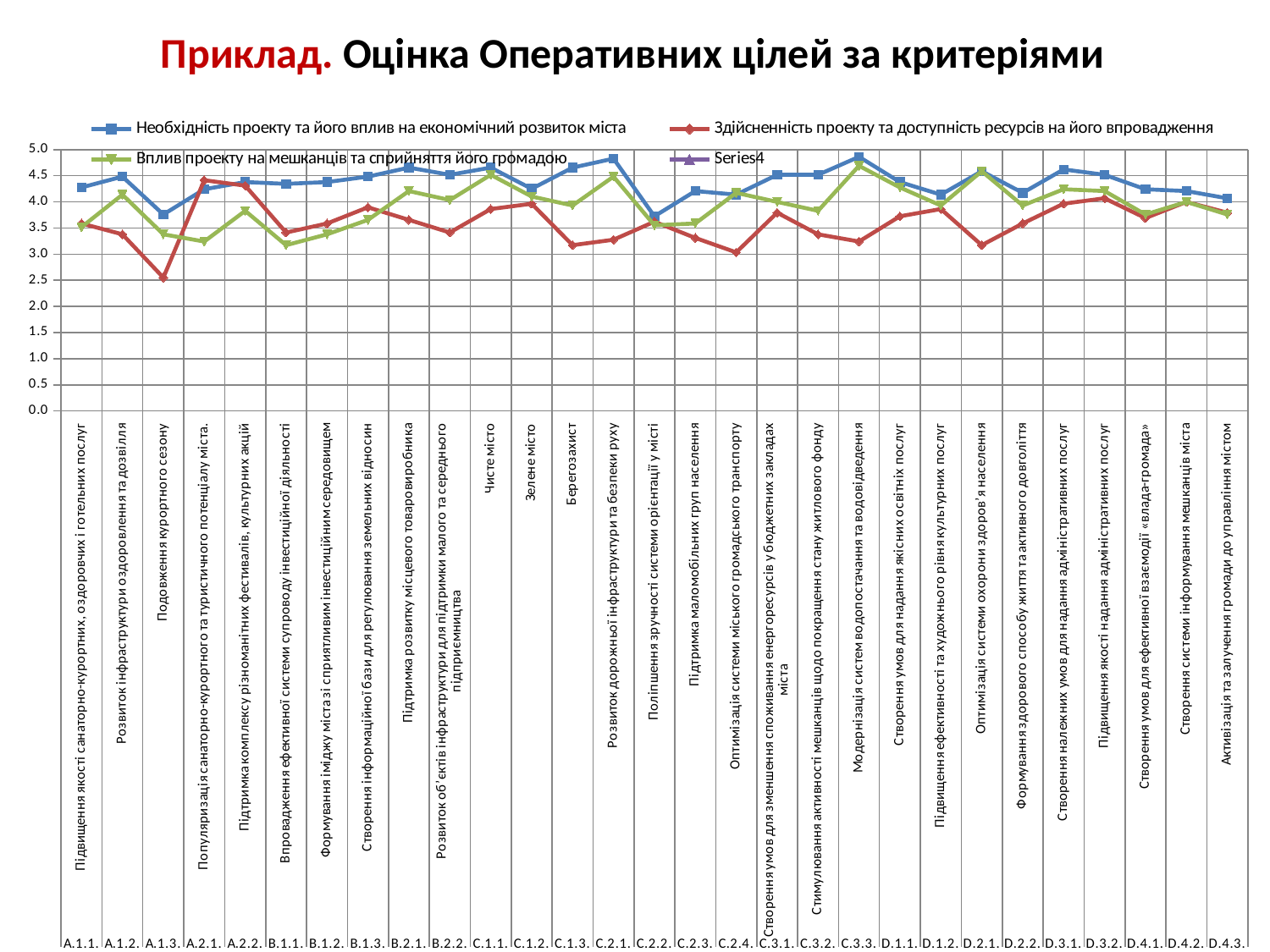
For A.2.1, which series has the larger value: 'Здійсненність проекту та доступність ресурсів на його впровадження' or 'Вплив проекту на мешканців та сприйняття його громадою'? Здійсненність проекту та доступність ресурсів на його впровадження Which category has the highest value for the series 'Вплив проекту на мешканців та сприйняття його громадою'? C.3.3. Модернізація систем водопостачання та водовідведення Is the value of 'Здійсненність проекту та доступність ресурсів на його впровадження' for A.2.1 greater or less than 4.0? greater What kind of chart is shown on the slide? line chart Which category has the lowest value for the series 'Здійсненність проекту та доступність ресурсів на його впровадження'? A.1.3. Подовження курортного сезону How many series does the legend list? 4 What is the maximum value shown on the vertical axis? 5.0 Is the value of 'Здійсненність проекту та доступність ресурсів на його впровадження' for A.1.3 (Подовження курортного сезону) greater or less than 3.0? less Is the value of 'Необхідність проекту та його вплив на економічний розвиток міста' for C.3.3 (Модернізація систем водопостачання та водовідведення) greater or less than 4.5? greater How many categories (operational goals) are plotted along the x axis? 29 For A.1.3 (Подовження курортного сезону), which series has the larger value: 'Необхідність проекту та його вплив на економічний розвиток міста' or 'Здійсненність проекту та доступність ресурсів на його впровадження'? Необхідність проекту та його вплив на економічний розвиток міста What is the title of the slide containing the chart? Приклад. Оцінка Оперативних цілей за критеріями